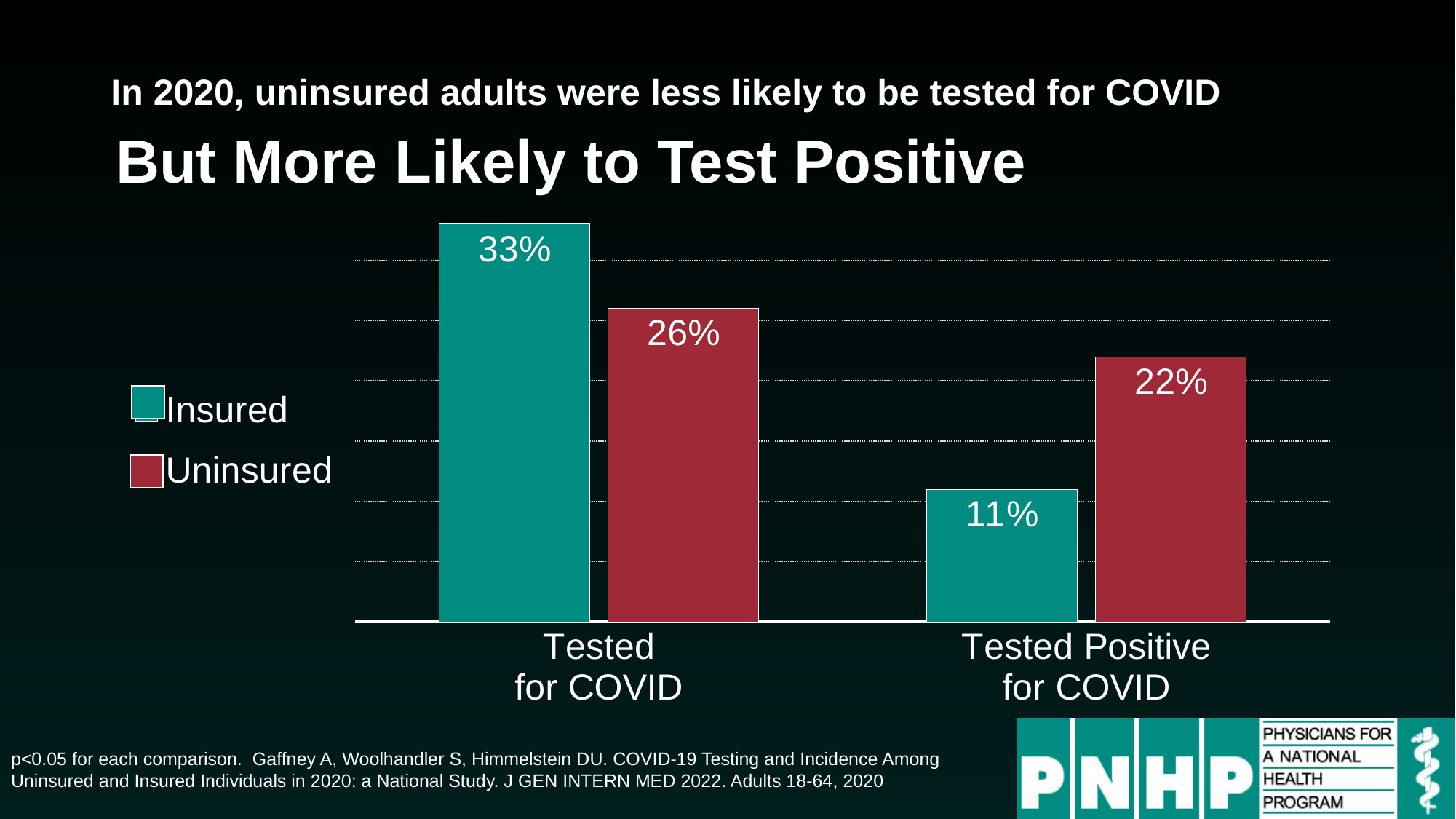
What percentage of uninsured adults tested positive for COVID? 22% What percentage of insured adults were tested for COVID? 33% How many series does the legend list? 2 How many categories are shown on the x axis of the chart? 2 What percentage of uninsured adults were tested for COVID? 26% What percentage of insured adults tested positive for COVID? 11% Which bar in the chart has the highest value? Insured, Tested for COVID Which bar in the chart has the lowest value? Insured, Tested Positive for COVID What is the difference between the insured and uninsured percentages tested for COVID? 7% What is the difference between the uninsured and insured percentages that tested positive for COVID? 11% For Tested Positive for COVID, which group has the larger value, Insured or Uninsured? Uninsured What kind of chart is shown on the slide? Bar chart